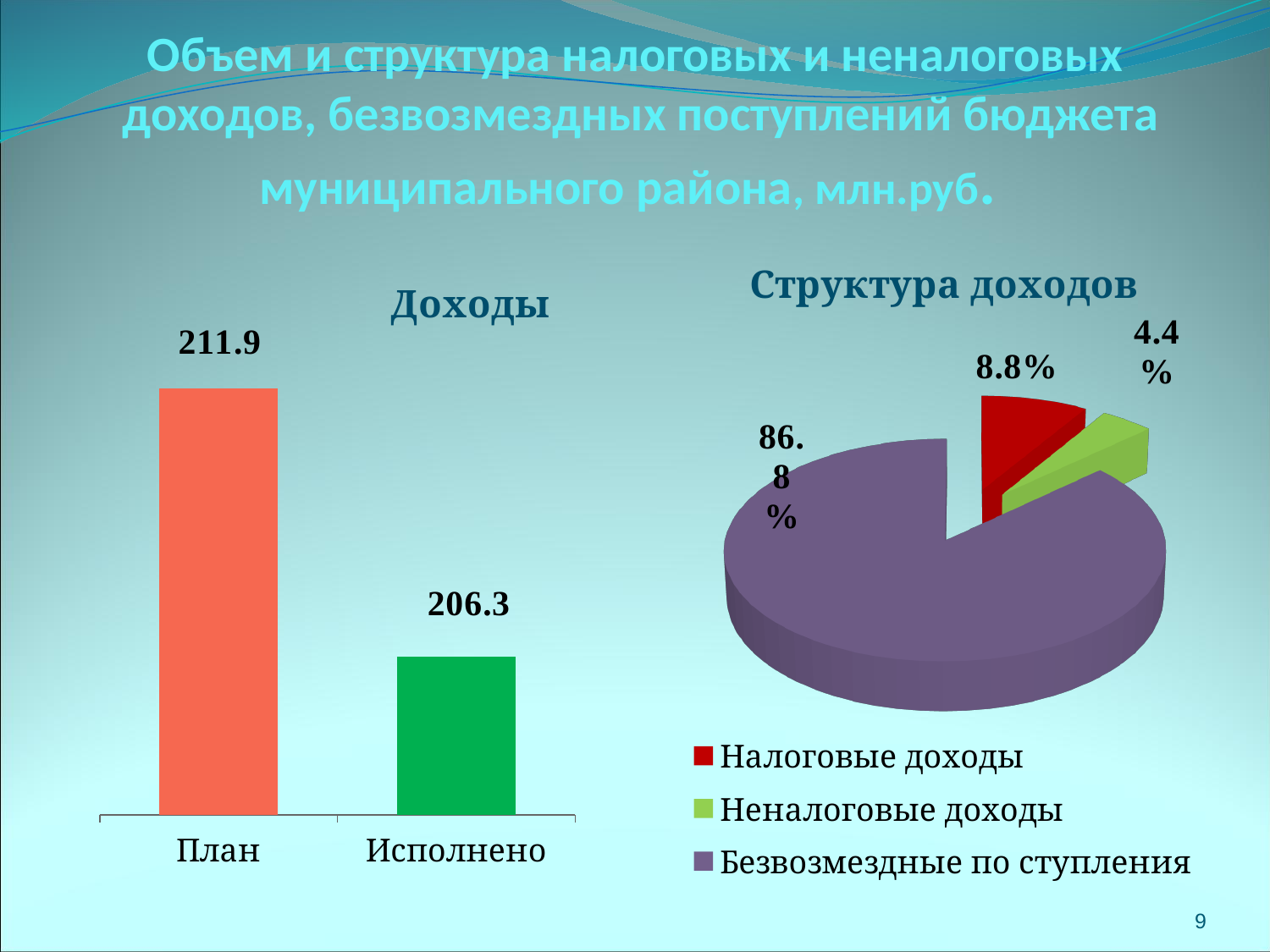
In the "Доходы" chart, which category has the higher value? План In the "Доходы" chart, what is the value for Исполнено? 206.3 In the "Структура доходов" chart, which category has the smallest share? Неналоговые доходы What kind of chart is the "Доходы" chart? Bar chart In the "Структура доходов" chart, what share is Безвозмездные поступления? 86.8% In the "Доходы" chart, how many bars are shown? 2 In the "Доходы" chart, what is the difference between План and Исполнено? 5.6 In the "Доходы" chart, what is the value for План? 211.9 In the "Структура доходов" chart, which category has the largest share? Безвозмездные поступления What kind of chart is the "Структура доходов" chart? Pie chart In the "Структура доходов" chart, what share is Налоговые доходы? 8.8% In the "Структура доходов" chart, what share is Неналоговые доходы? 4.4%